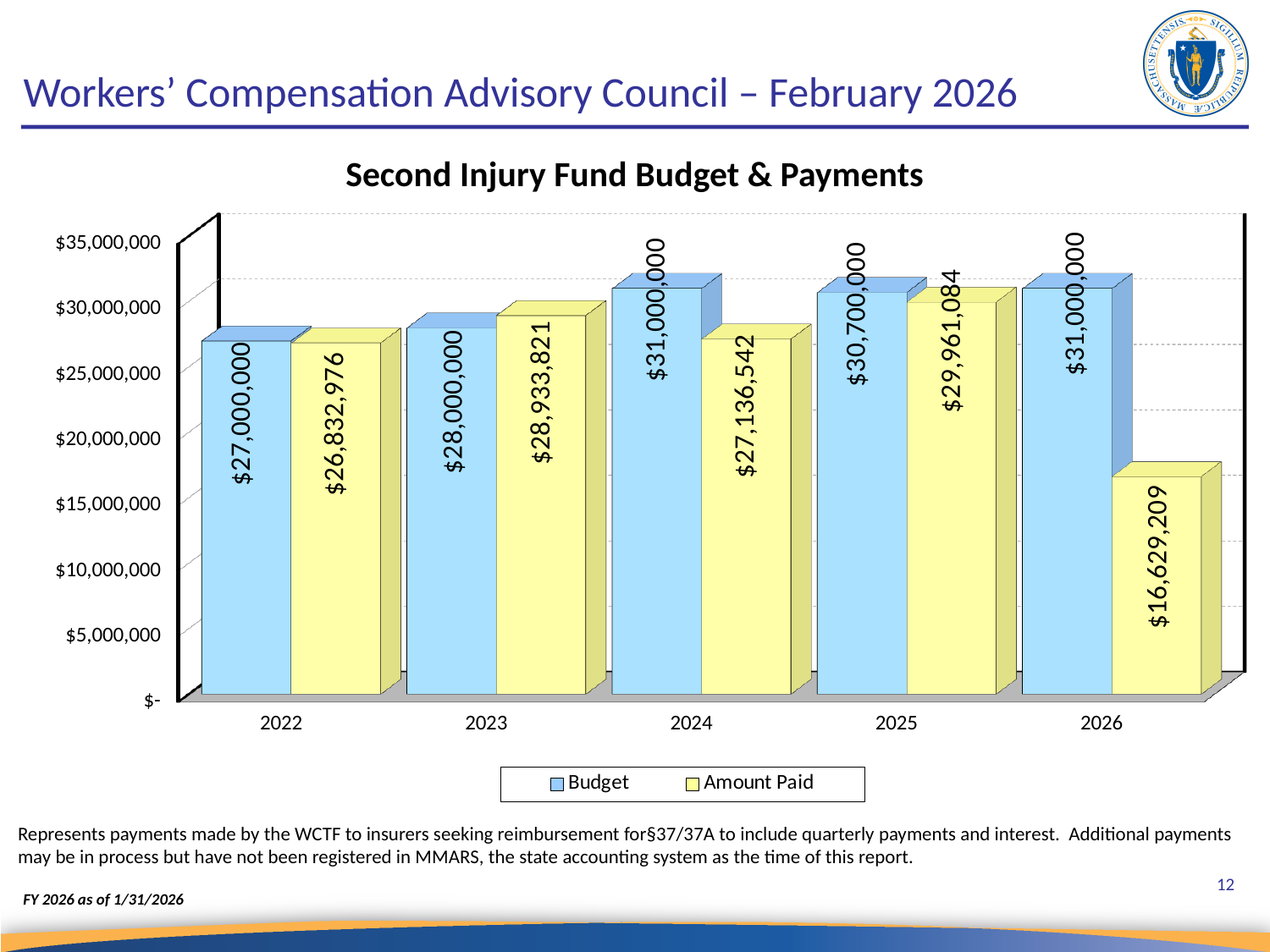
How many series does the legend list? 2 Which year has the lowest Amount Paid? 2026 What is the Amount Paid for 2026? $16,629,209 In 2023, which is larger: the Budget or the Amount Paid? Amount Paid Which year has the highest Amount Paid? 2025 Is the Amount Paid for 2026 greater or less than $20,000,000? less What is the Amount Paid for 2023? $28,933,821 What is the difference between the Budget and the Amount Paid in 2026? $14,370,791 Which year has the lowest Budget? 2022 How many years are shown on the x axis? 5 What is the Budget value for 2024? $31,000,000 What kind of chart is shown on the slide? bar chart